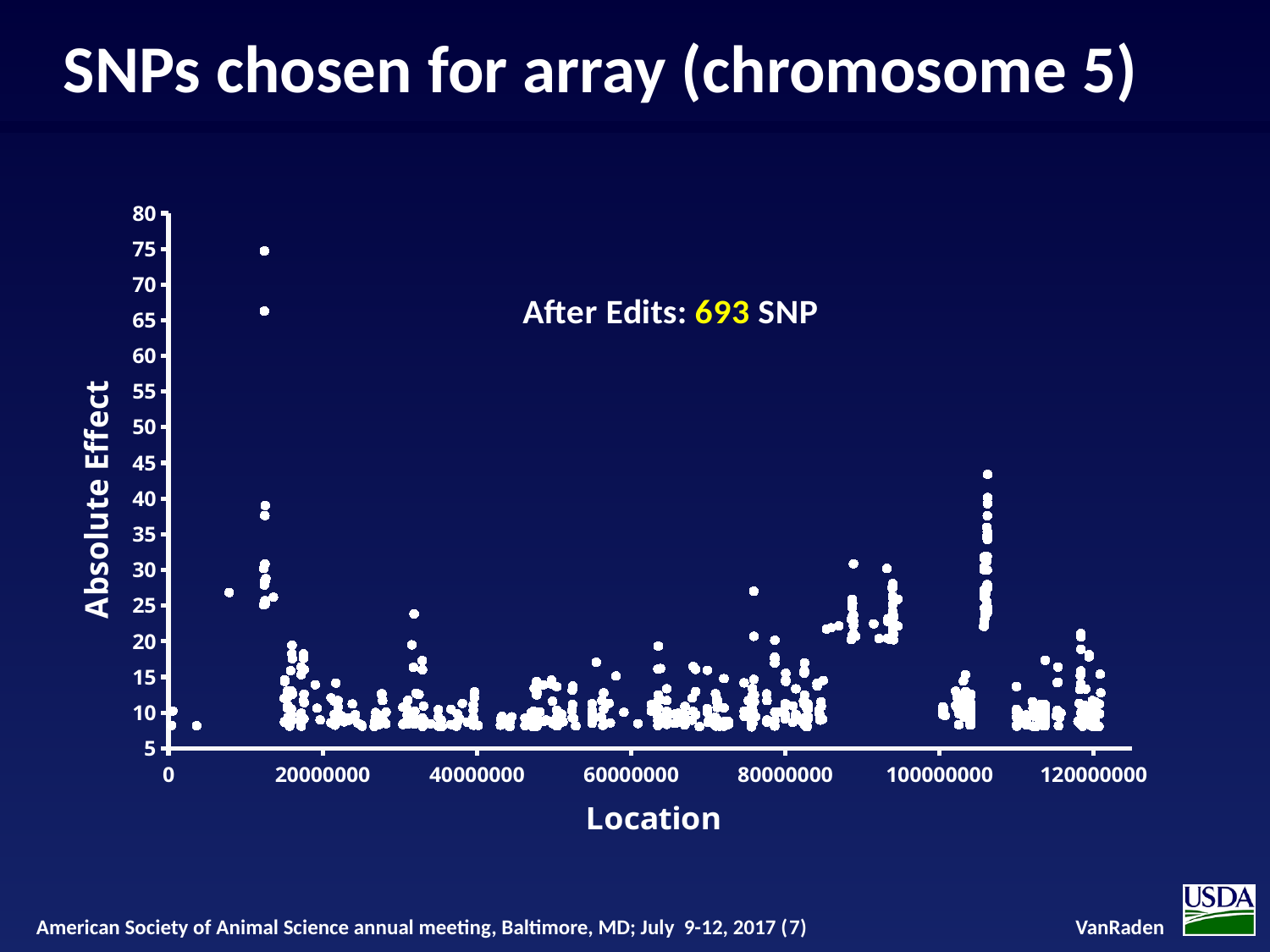
What is the label of the vertical axis? Absolute Effect Is the highest point in the cluster near location 106000000 greater or less than 50 on the Absolute Effect axis? less Is the highest plotted Absolute Effect value greater or less than 70? greater What kind of chart is shown on the slide? scatter plot Is the highest point near location 32000000 greater or less than 30 on the Absolute Effect axis? less Which location region contains the point with the highest Absolute Effect: near 12000000 or near 106000000? near 12000000 According to the annotation on the chart, how many SNPs remain after edits? 693 What is the title of the chart on the slide? SNPs chosen for array (chromosome 5)